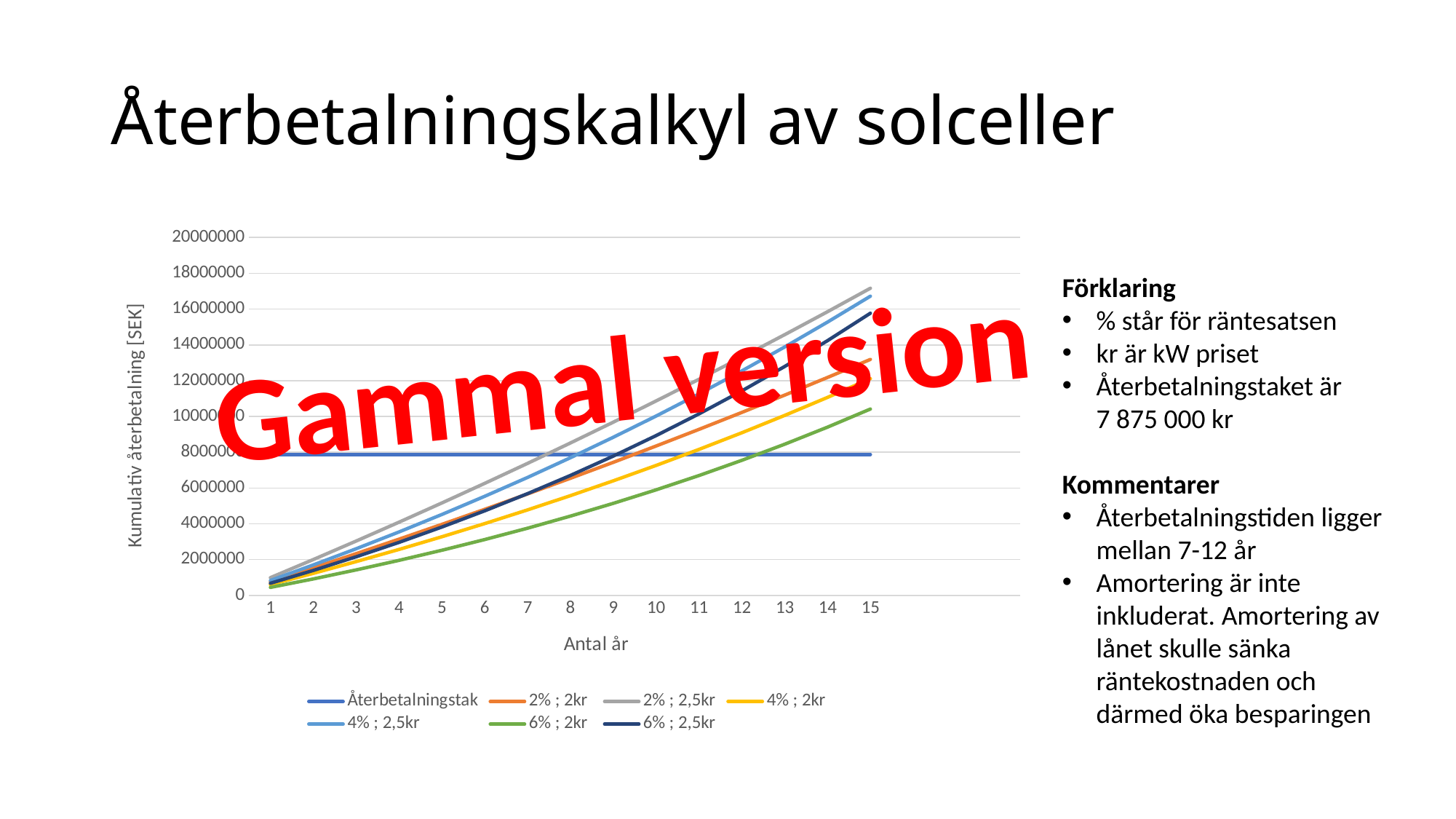
Does the '4% ; 2kr' series rise or fall as the number of years increases? rises At year 15, which is larger: the value for '6% ; 2,5kr' or the value for '6% ; 2kr'? 6% ; 2,5kr How many series does the chart legend list? 7 How many years are shown along the x axis of the chart? 15 What is the title of the x axis of the chart? Antal år What kind of chart is shown on the slide? line chart What is the title of the y axis of the chart? Kumulativ återbetalning [SEK] Is the value of the 'Återbetalningstak' line greater or less than 10000000? less Among the rising series, which has the lowest value at year 15? 6% ; 2kr Which series has the highest value at year 15? 2% ; 2,5kr Is the value for '6% ; 2kr' at year 15 greater or less than 12000000? less Is the value for '2% ; 2,5kr' at year 15 greater or less than 16000000? greater